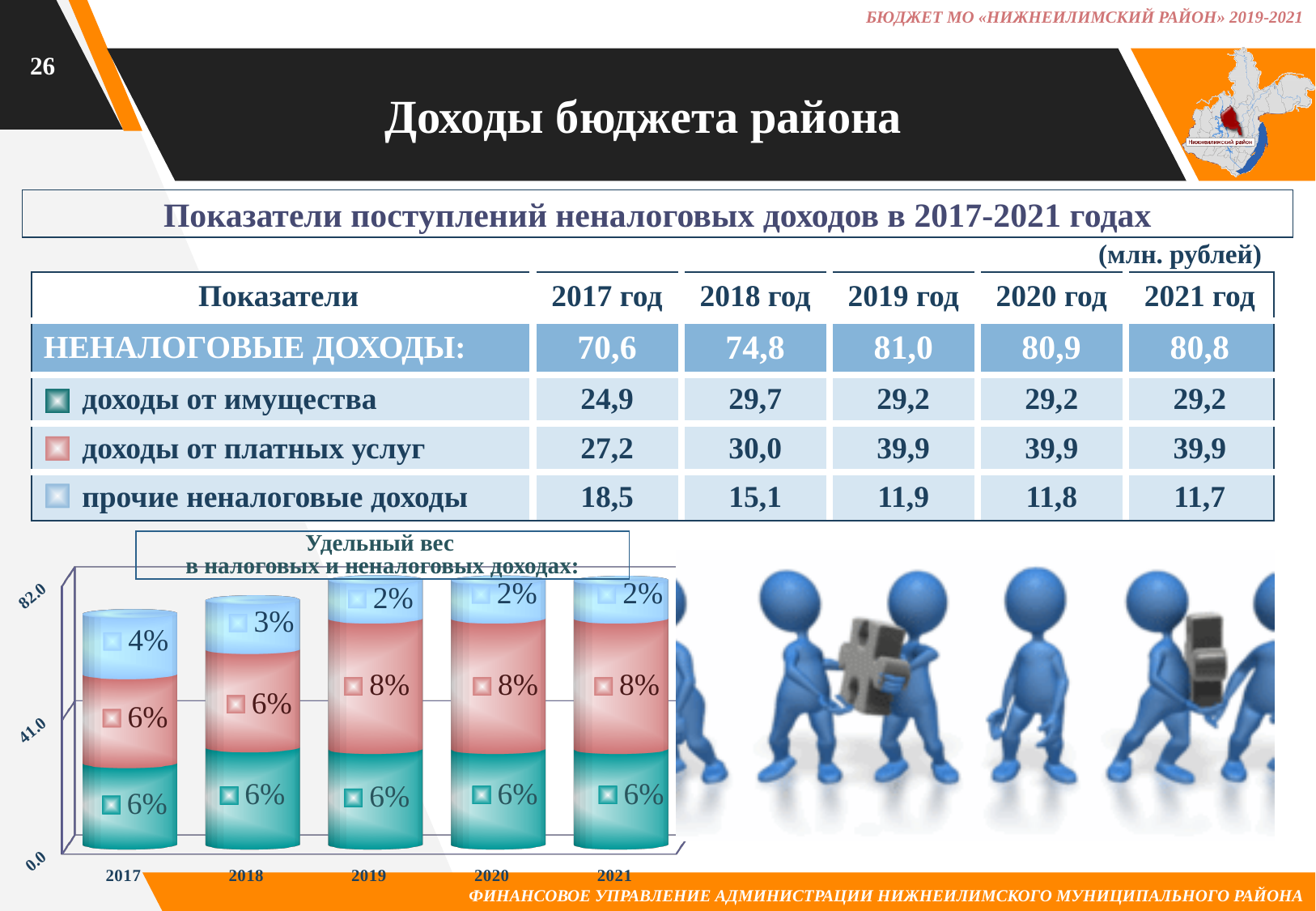
In the chart, what is the value of the top (light blue, прочие неналоговые доходы) segment for 2017? 4% Which is larger in 2018: the pink (доходы от платных услуг) segment or the light blue (прочие неналоговые доходы) segment? pink (доходы от платных услуг) In the chart, what is the value of the middle (pink, доходы от платных услуг) segment for 2019? 8% What is the title of the chart? Удельный вес в налоговых и неналоговых доходах: In which year is the top (light blue, прочие неналоговые доходы) segment the highest? 2017 How many years (categories) are shown on the x axis of the chart? 5 In the chart, what is the value of the top (light blue) segment for 2018? 3% What kind of chart is shown at the bottom left of the slide? stacked bar chart What is the total of the stacked bar for 2020? 16% What is the difference between the pink (доходы от платных услуг) segment in 2019 and in 2017? 2% What is the total of the stacked bar for 2018? 15% In the chart, what is the value of the bottom (green, доходы от имущества) segment for 2021? 6%